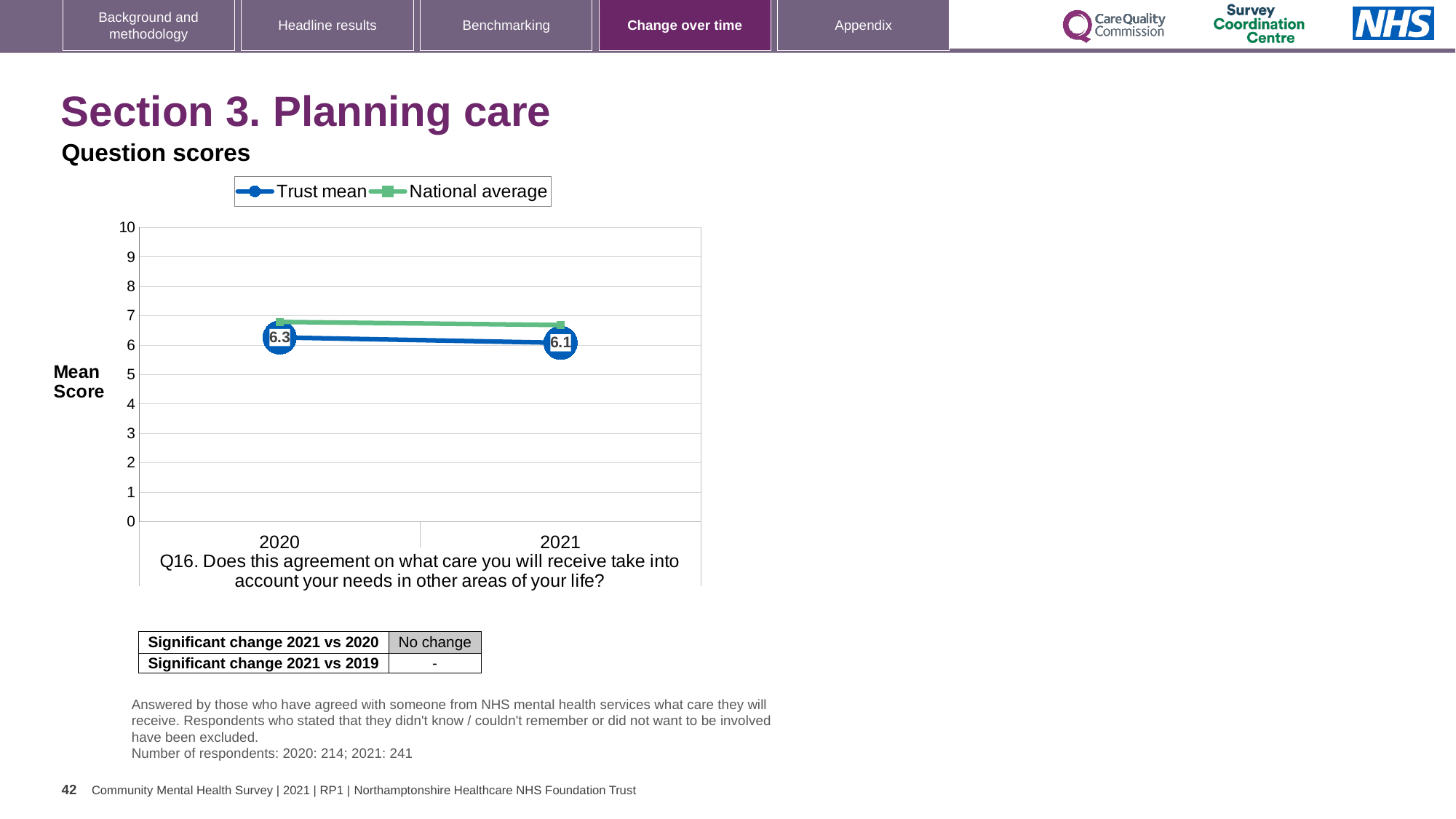
In 2021, which is higher: the Trust mean or the National average? National average What is the Trust mean score for 2021? 6.1 In which year was the Trust mean score higher, 2020 or 2021? 2020 Is the National average for 2020 greater or less than 6? greater What kind of chart is shown on the slide? line chart By how much did the Trust mean score change from 2020 to 2021? 0.2 What is the label of the y axis? Mean Score What is the Trust mean score for 2020? 6.3 Does the Trust mean rise or fall from 2020 to 2021? fall Is the National average for 2021 greater or less than 7? less How many series does the legend list? 2 How many years are plotted on the x axis? 2